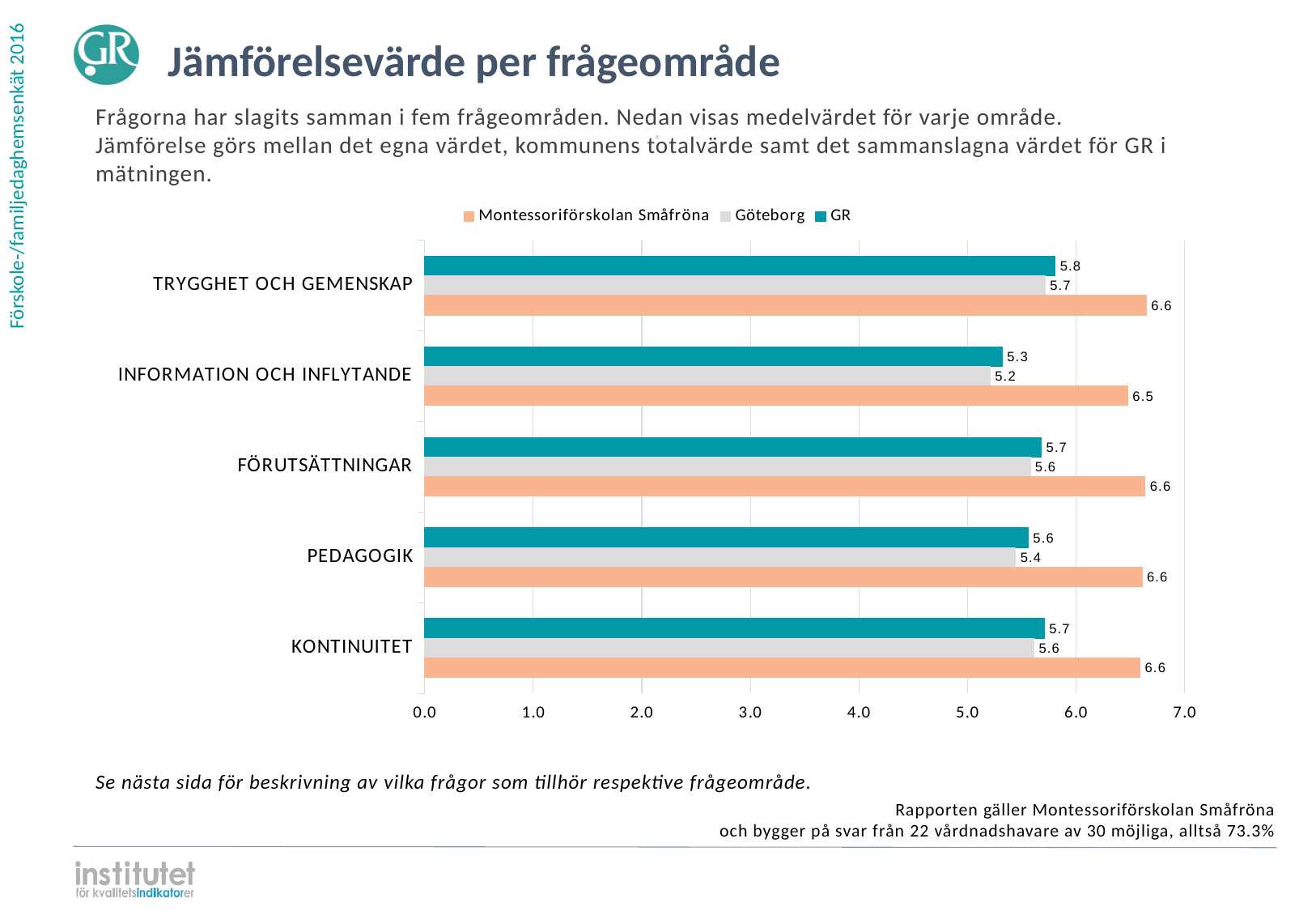
What is the value for Montessoriförskolan Småfröna in INFORMATION OCH INFLYTANDE? 6.5 Which category has the highest value for GR? TRYGGHET OCH GEMENSKAP What is the difference between the Montessoriförskolan Småfröna value and the Göteborg value in INFORMATION OCH INFLYTANDE? 1.3 What is the value for GR in TRYGGHET OCH GEMENSKAP? 5.8 Which category has the lowest value for Göteborg? INFORMATION OCH INFLYTANDE In PEDAGOGIK, which is larger: the value for GR or the value for Göteborg? GR Which series is shown in orange in the legend? Montessoriförskolan Småfröna What is the value for Göteborg in PEDAGOGIK? 5.4 What type of chart is shown on the slide? Bar chart How many question areas (categories) are shown on the chart? 5 Is the value for Montessoriförskolan Småfröna in KONTINUITET greater or less than 6.0? greater How many series does the legend list? 3